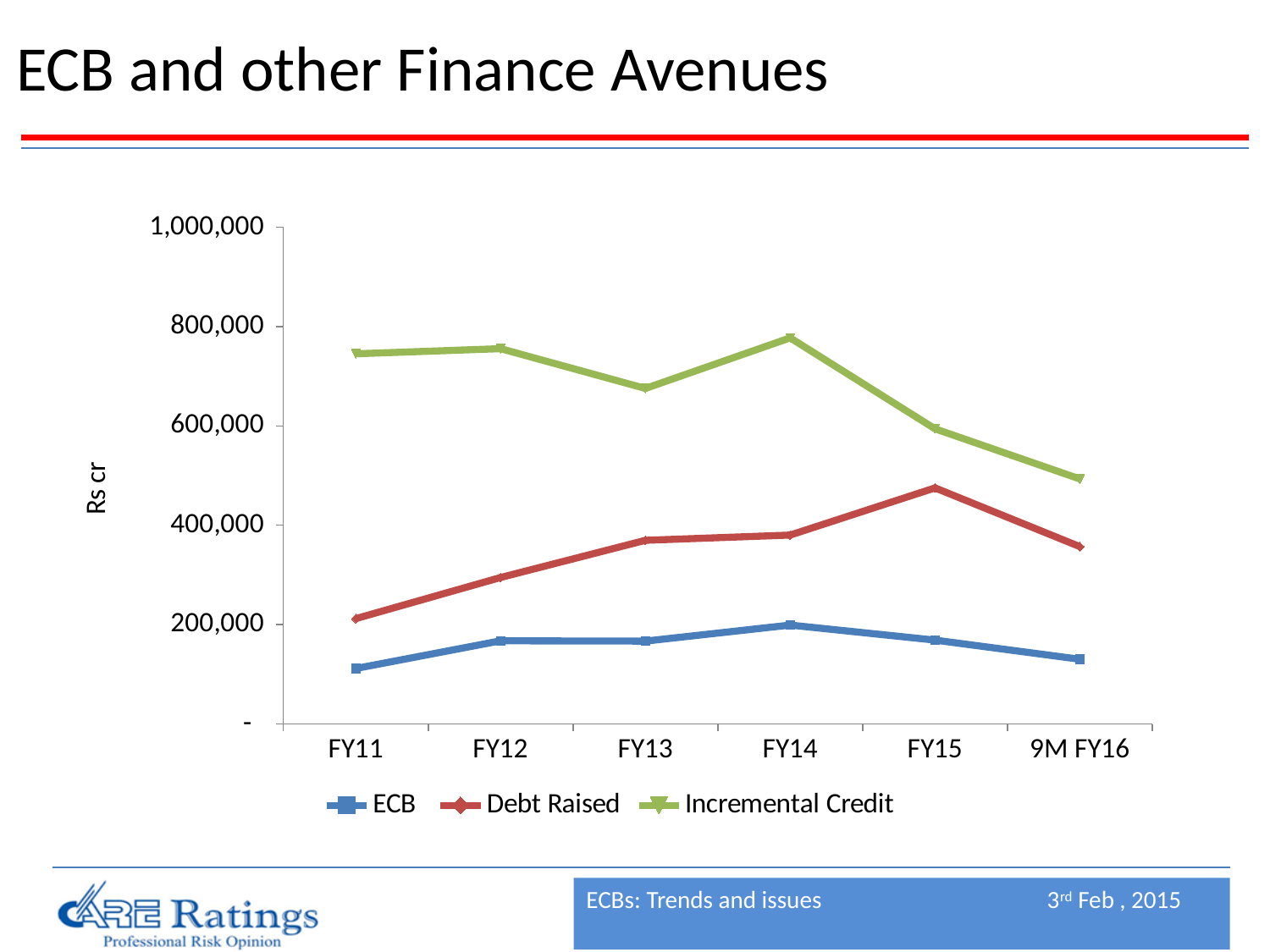
What is the label on the y axis? Rs cr Which is larger in FY15, Debt Raised or ECB? Debt Raised Is the value for ECB in FY11 greater or less than 200,000? less What kind of chart is shown on the slide? Line chart Is the value for Incremental Credit in FY11 greater or less than 600,000? greater In which period is Incremental Credit lowest? 9M FY16 In which period is Debt Raised highest? FY15 In which period is ECB highest? FY14 How many series does the legend list? 3 Is the value for Debt Raised in FY15 greater or less than 400,000? greater How many periods are shown on the x axis? 6 Does Debt Raised rise or fall from FY11 to FY15? Rise